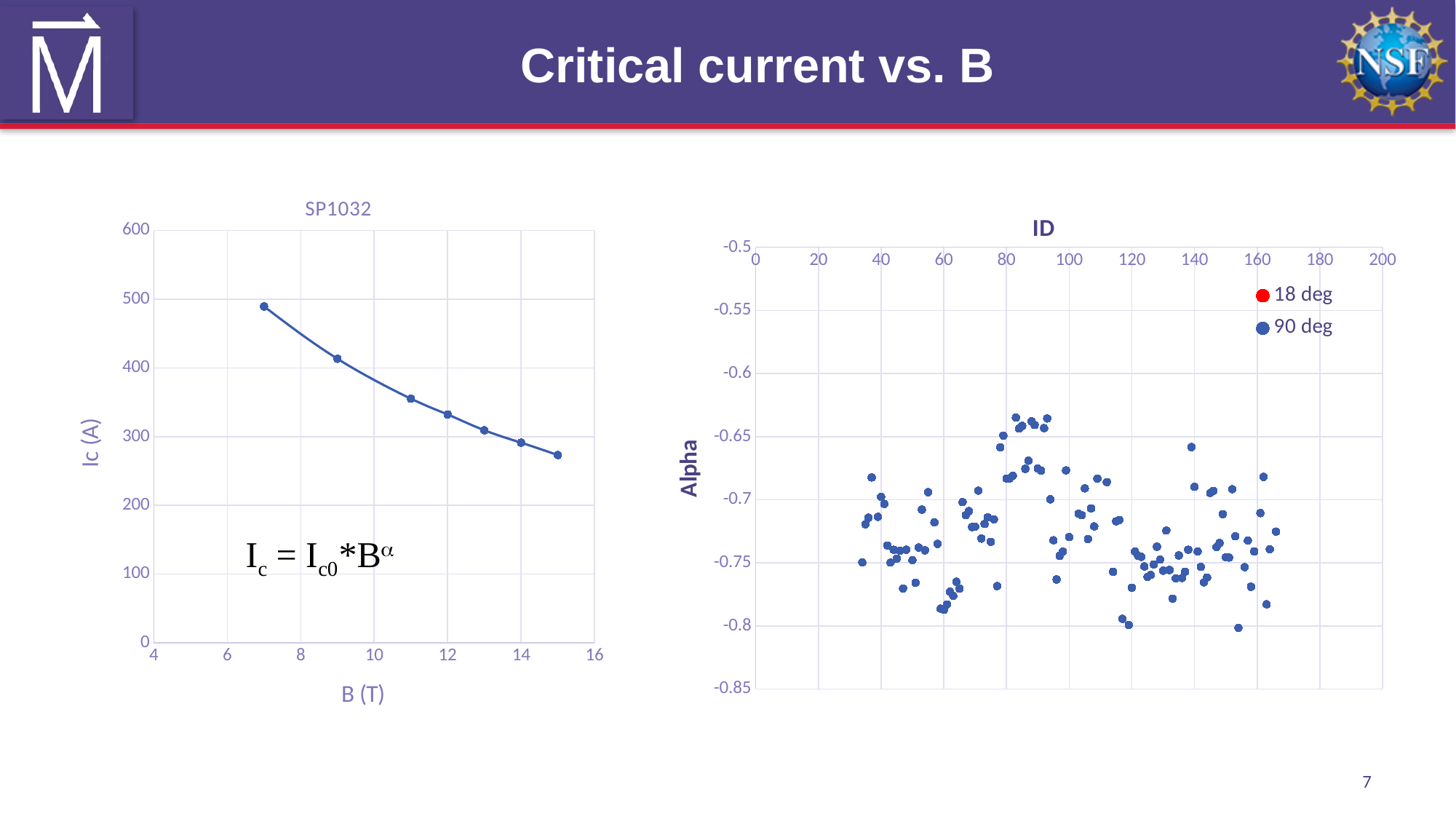
In the SP1032 chart on the left, what is the label of the x axis? B (T) In the SP1032 chart on the left, is the value of Ic at B = 15 T greater or less than 300? less In the SP1032 chart on the left, is the value of Ic at B = 11 T greater or less than 400? less In the ID chart on the right, what is the label of the y axis? Alpha In the ID chart on the right, how many series does the legend list? 2 In the SP1032 chart on the left, at which B value is Ic highest? 7 In the SP1032 chart on the left, does Ic rise or fall as B increases? fall In the SP1032 chart on the left, at which B value is Ic lowest? 15 In the SP1032 chart on the left, what kind of chart is it? line chart In the SP1032 chart on the left, is the value of Ic at B = 7 T greater or less than 400? greater In the SP1032 chart on the left, how many data points are plotted? 7 In the SP1032 chart on the left, which has the larger Ic: B = 9 T or B = 13 T? B = 9 T